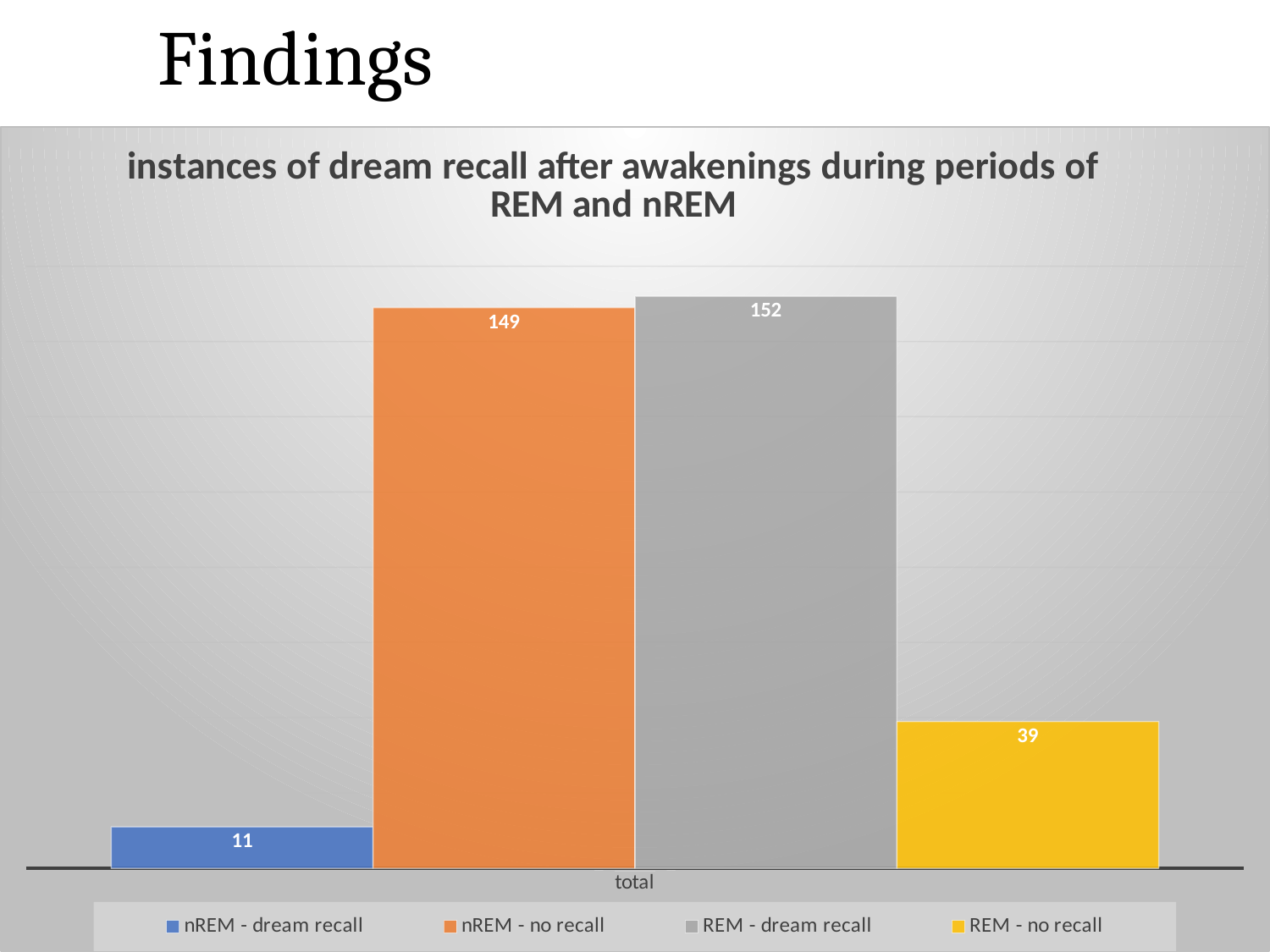
What is the difference between REM - dream recall and nREM - dream recall? 141 What is the value for REM - no recall? 39 What is the difference between nREM - no recall and REM - no recall? 110 What is the title of the chart? instances of dream recall after awakenings during periods of REM and nREM What is the value for nREM - no recall? 149 What is the value for REM - dream recall? 152 Which series has the lowest value? nREM - dream recall What kind of chart is shown on the slide? Bar chart Which series has the highest value? REM - dream recall How many series does the legend list? 4 What is the value for nREM - dream recall? 11 Which is larger, REM - no recall or nREM - dream recall? REM - no recall